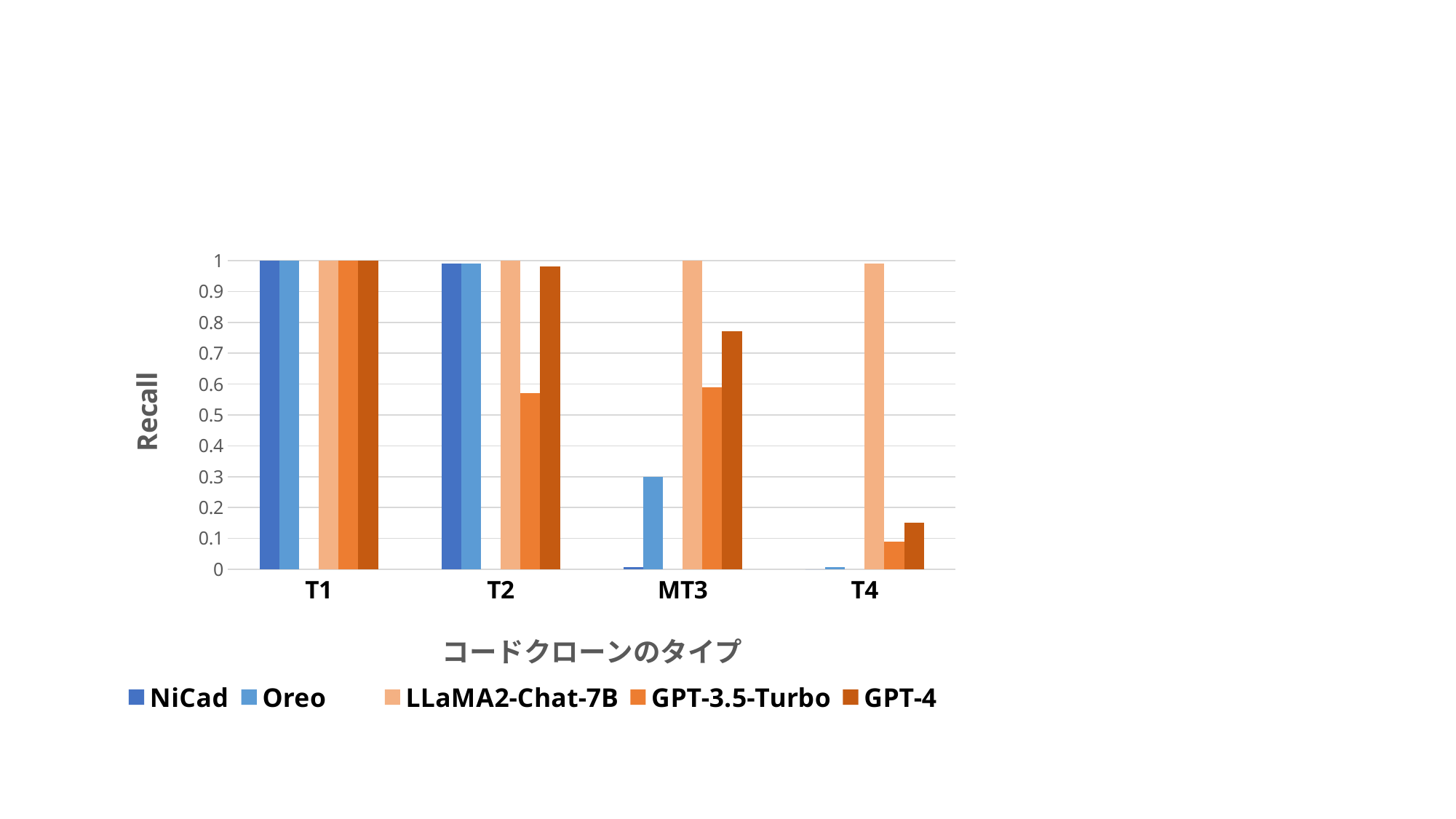
Is the Recall value for GPT-4 at MT3 greater or less than 0.7? greater How many series does the legend list? 5 How many categories are shown on the x axis? 4 What kind of chart is shown on the slide? bar chart Which series has the highest Recall at T4? LLaMA2-Chat-7B At T2, which has the larger Recall: GPT-4 or GPT-3.5-Turbo? GPT-4 What is the Recall value for LLaMA2-Chat-7B at MT3? 1 Does the Recall for GPT-4 rise or fall from T1 to T4? fall Which series has the lowest Recall at MT3? NiCad What is the Recall value for GPT-4 at T1? 1 What is the label on the y axis? Recall Is the Recall value for GPT-4 at T4 greater or less than 0.2? less